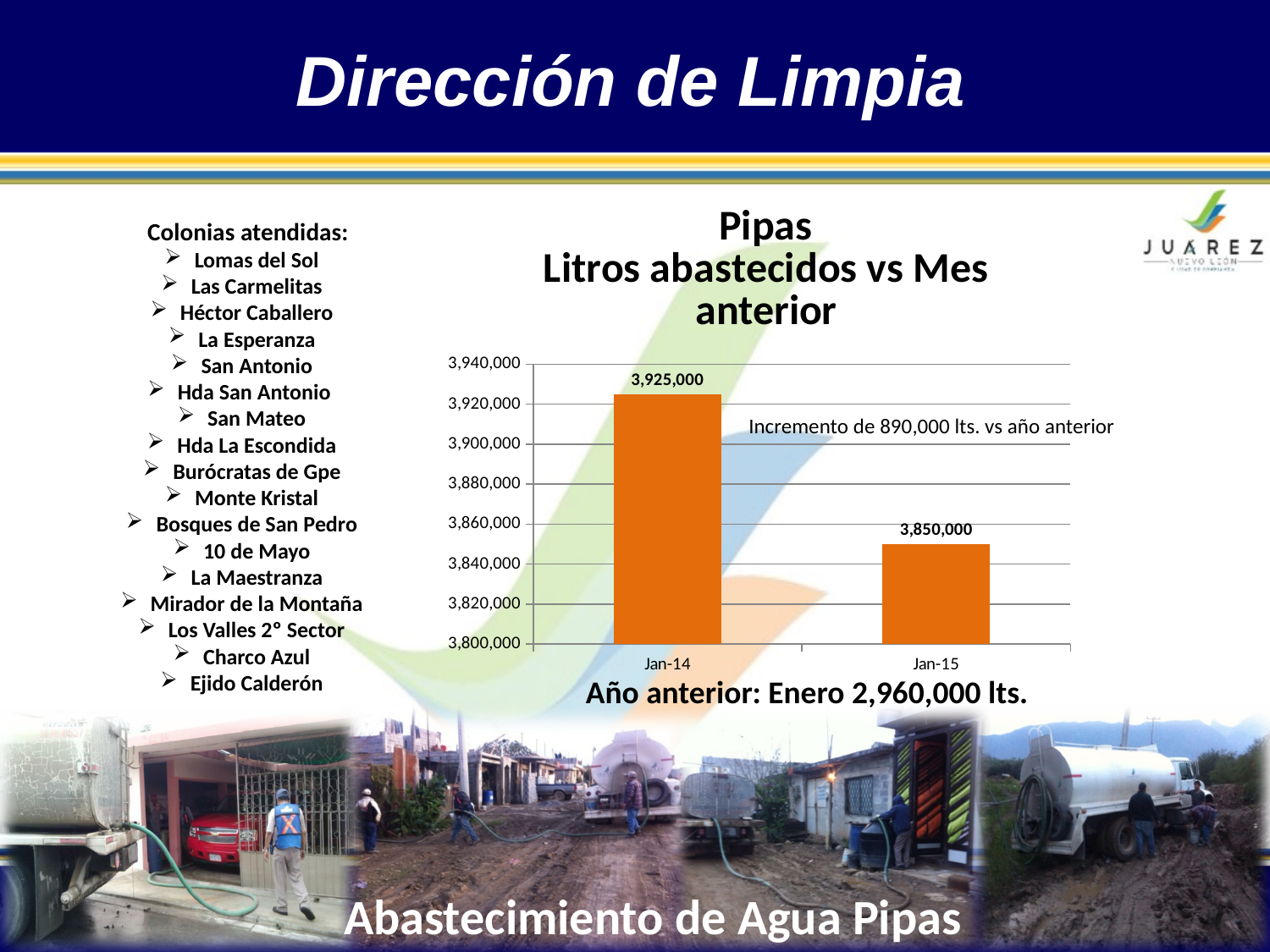
Do the values rise or fall from Jan-14 to Jan-15? fall What is the difference between the Jan-14 and Jan-15 values? 75,000 Which category has the lowest value in the chart? Jan-15 Is the value for Jan-14 greater or less than 3,900,000? greater What is the title of the chart? Pipas Litros abastecidos vs Mes anterior Is the value for Jan-15 greater or less than 3,860,000? less Which is larger, the value for Jan-14 or the value for Jan-15? Jan-14 What value is shown for Jan-15 in the chart? 3,850,000 Which category has the highest value in the chart? Jan-14 How many categories are plotted in the chart? 2 What kind of chart is shown on the slide? bar chart What value is shown for Jan-14 in the chart? 3,925,000